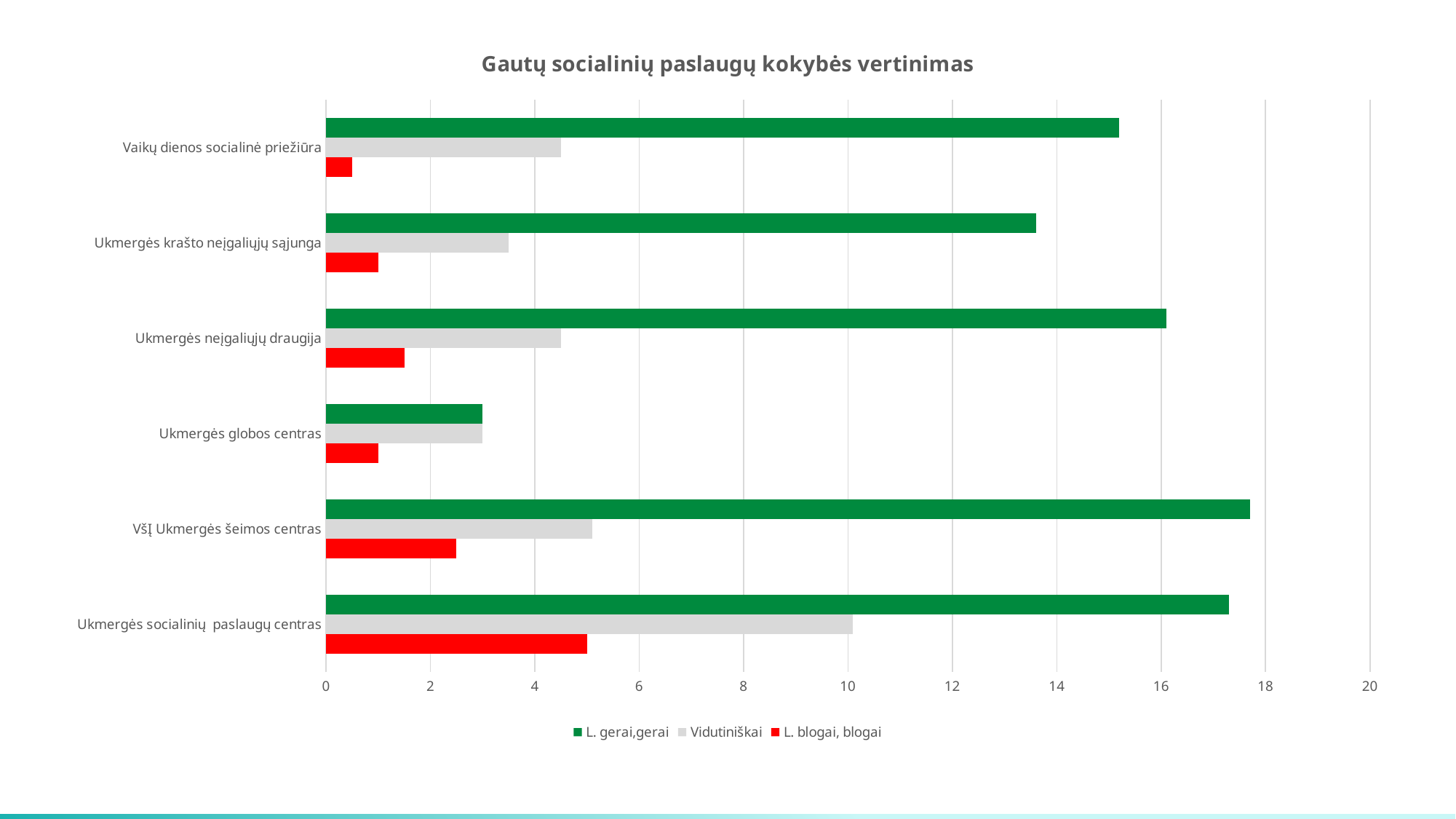
What is the title of the chart? Gautų socialinių paslaugų kokybės vertinimas Which category has the lowest 'L. gerai,gerai' value? Ukmergės globos centras Is the 'L. gerai,gerai' value for Vaikų dienos socialinė priežiūra greater or less than 14? greater Which category has the highest 'L. blogai, blogai' value? Ukmergės socialinių paslaugų centras Which colour represents the 'L. blogai, blogai' series? red Which category has the lowest 'L. blogai, blogai' value? Vaikų dienos socialinė priežiūra Which category has the highest 'Vidutiniškai' value? Ukmergės socialinių paslaugų centras How many series does the legend list? 3 Is the 'L. gerai,gerai' value for Ukmergės krašto neįgaliųjų sąjunga greater or less than 14? less What kind of chart is shown on the slide? bar chart Which is larger: the 'L. blogai, blogai' value for Ukmergės socialinių paslaugų centras or for VšĮ Ukmergės šeimos centras? Ukmergės socialinių paslaugų centras How many categories (organisations) are shown on the chart? 6